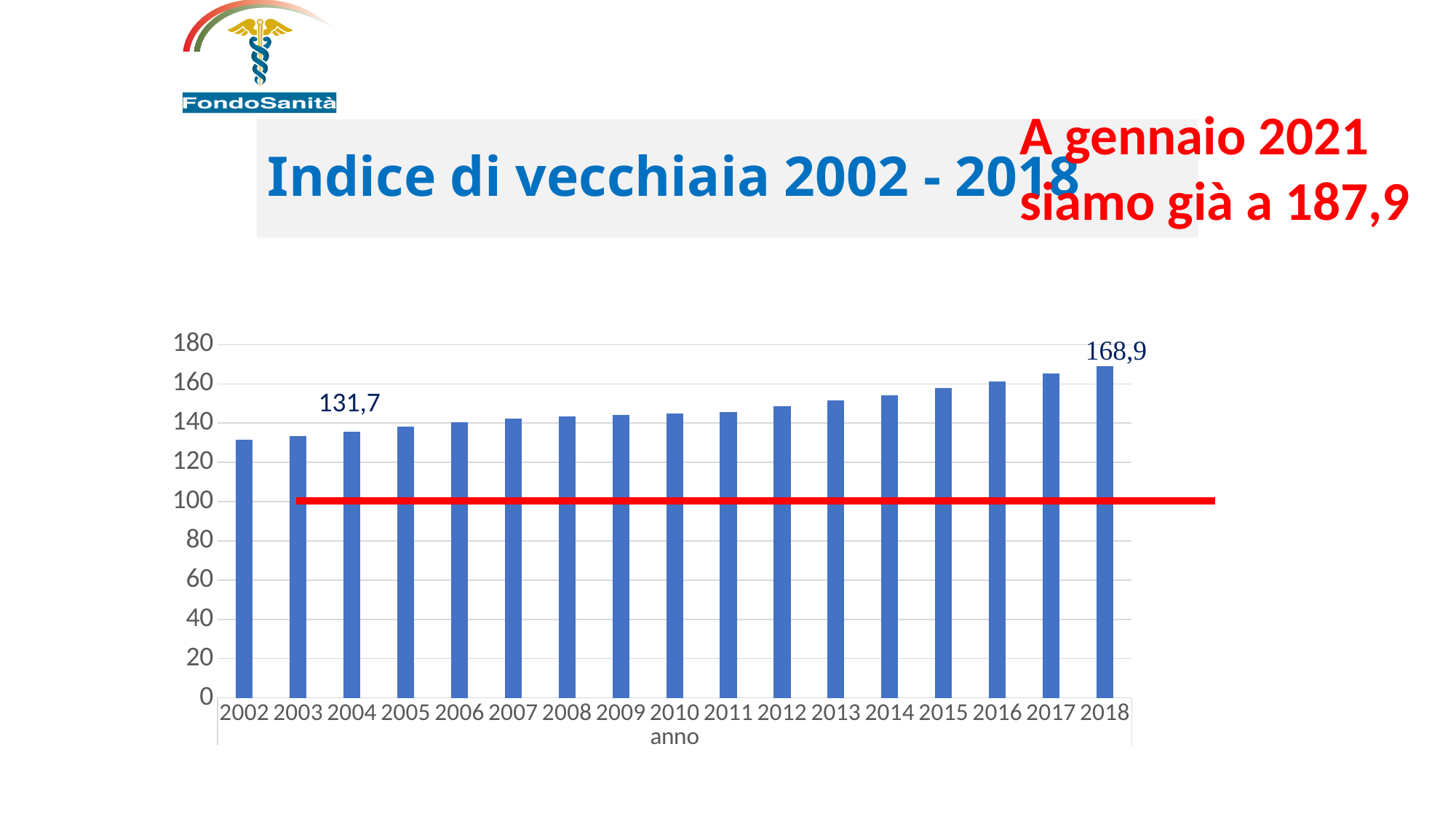
Which is larger, the value for 2017 or the value for 2014? 2017 What is the title of the chart? Indice di vecchiaia 2002 - 2018 How many years are shown on the x axis? 17 Do the values rise or fall from 2002 to 2018? rise Is the value for 2012 greater or less than 140? greater Which year has the highest value? 2018 Which year has the lowest value? 2002 Is the value for 2002 greater or less than 120? greater What is the value for 2018? 168,9 What kind of chart is this? bar chart